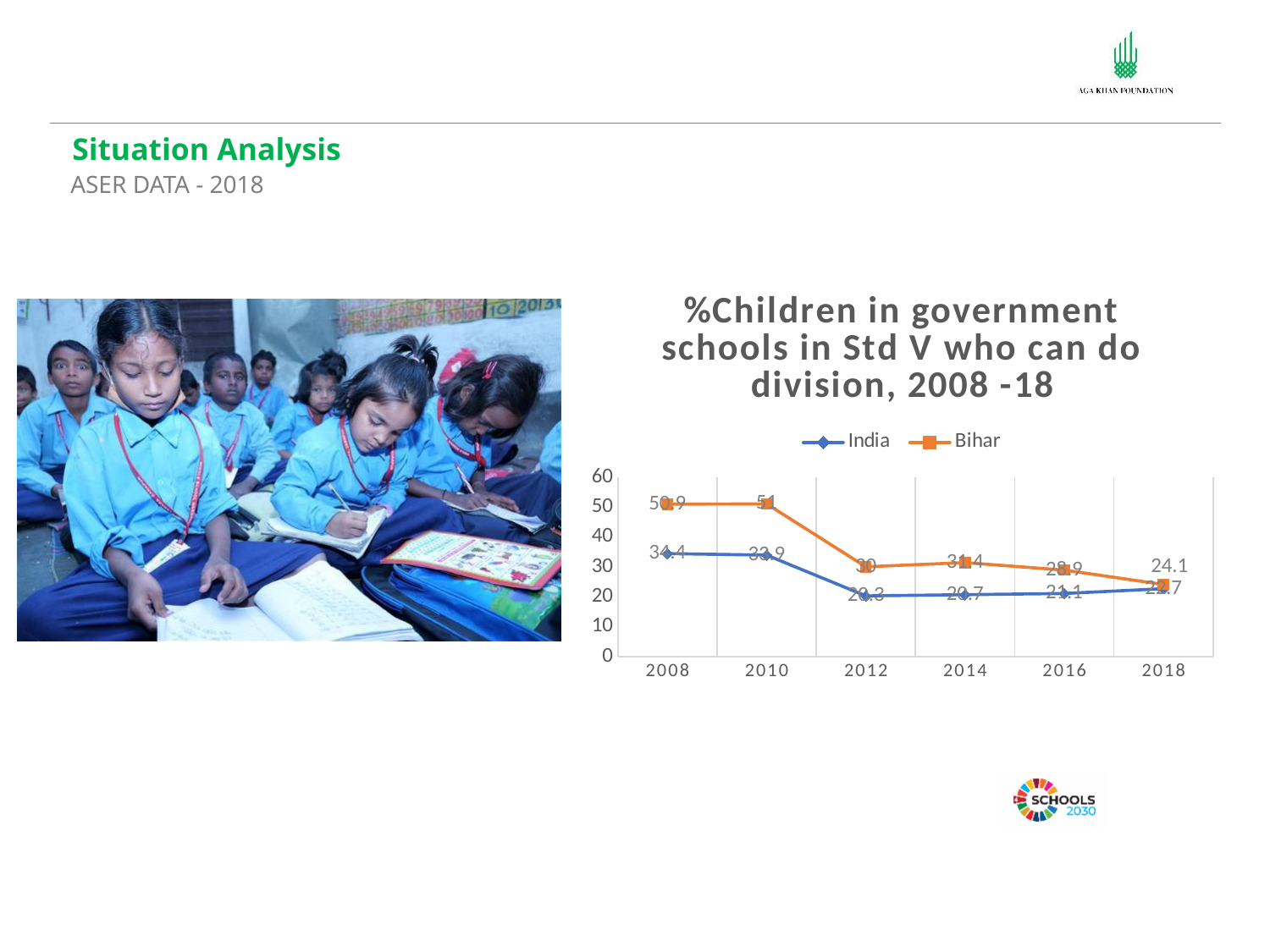
Does the India line rise or fall from 2008 to 2012? fall What is the value for India in 2010? 33.9 What is the value for Bihar in 2014? 31.4 What is the value for India in 2008? 34.4 In 2008, which series has the higher value, India or Bihar? Bihar How many years are plotted along the x axis? 6 What kind of chart is shown on the slide? line chart What is the difference between the India values for 2008 and 2010? 0.5 Is the value for Bihar in 2008 greater or less than 40? greater How many series does the chart's legend list? 2 What is the value for Bihar in 2018? 24.1 What is the value for Bihar in 2010? 51